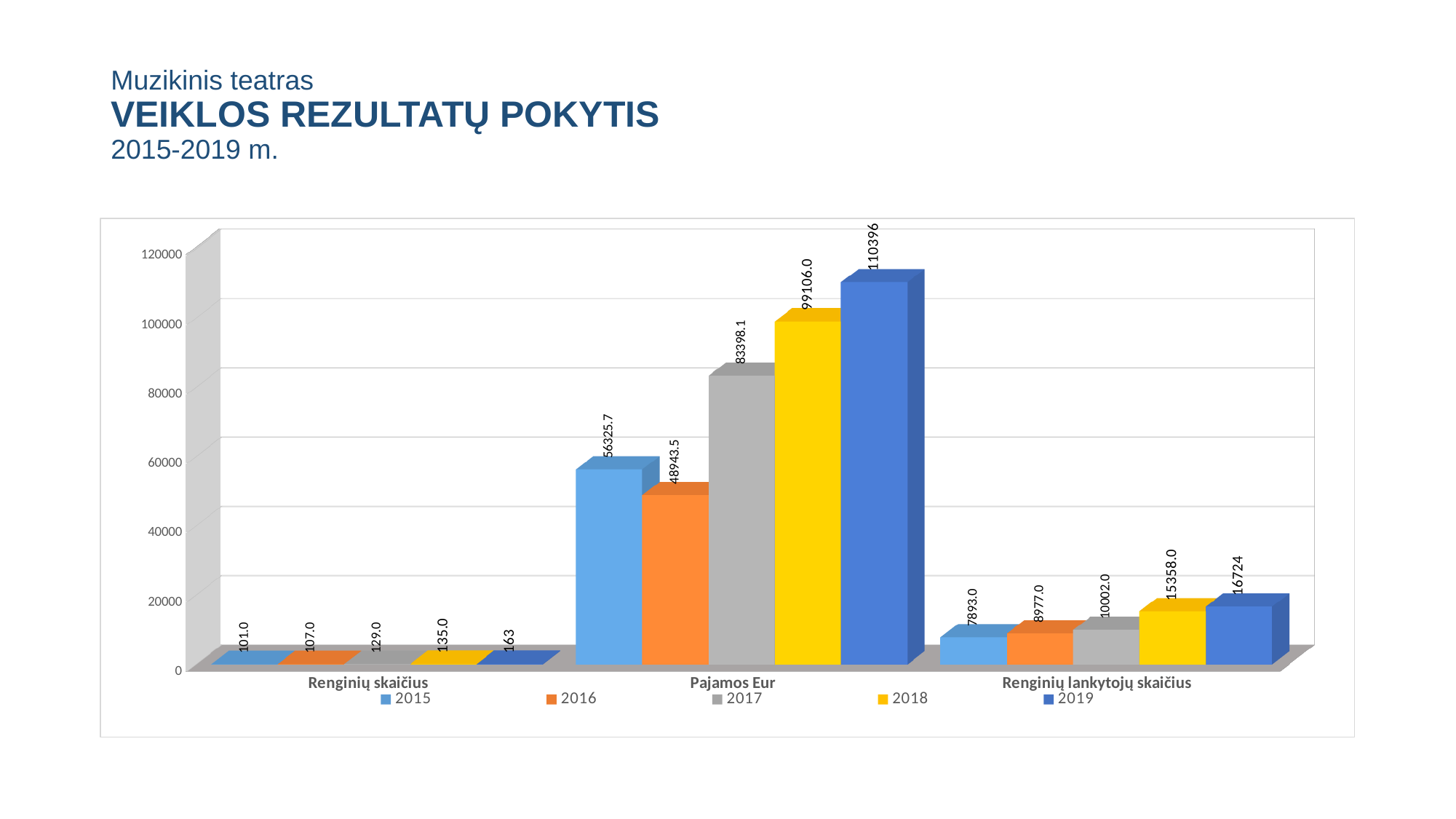
What is the value for 2018 in the Renginių lankytojų skaičius category? 15358.0 What is the value for 2019 in the Pajamos Eur category? 110396 Which year has the highest value in the Pajamos Eur category? 2019 Is the 2017 value in the Pajamos Eur category greater or less than 80000? greater How many categories are shown on the x axis? 3 What is the value for 2015 in the Renginių skaičius category? 101.0 How many series does the legend list? 5 Which year has the lowest value in the Pajamos Eur category? 2016 What is the difference between the 2019 and 2018 values in the Renginių lankytojų skaičius category? 1366 What kind of chart is shown on the slide? Bar chart What is the value for 2016 in the Pajamos Eur category? 48943.5 Which is larger in the Pajamos Eur category: the 2015 value or the 2016 value? 2015